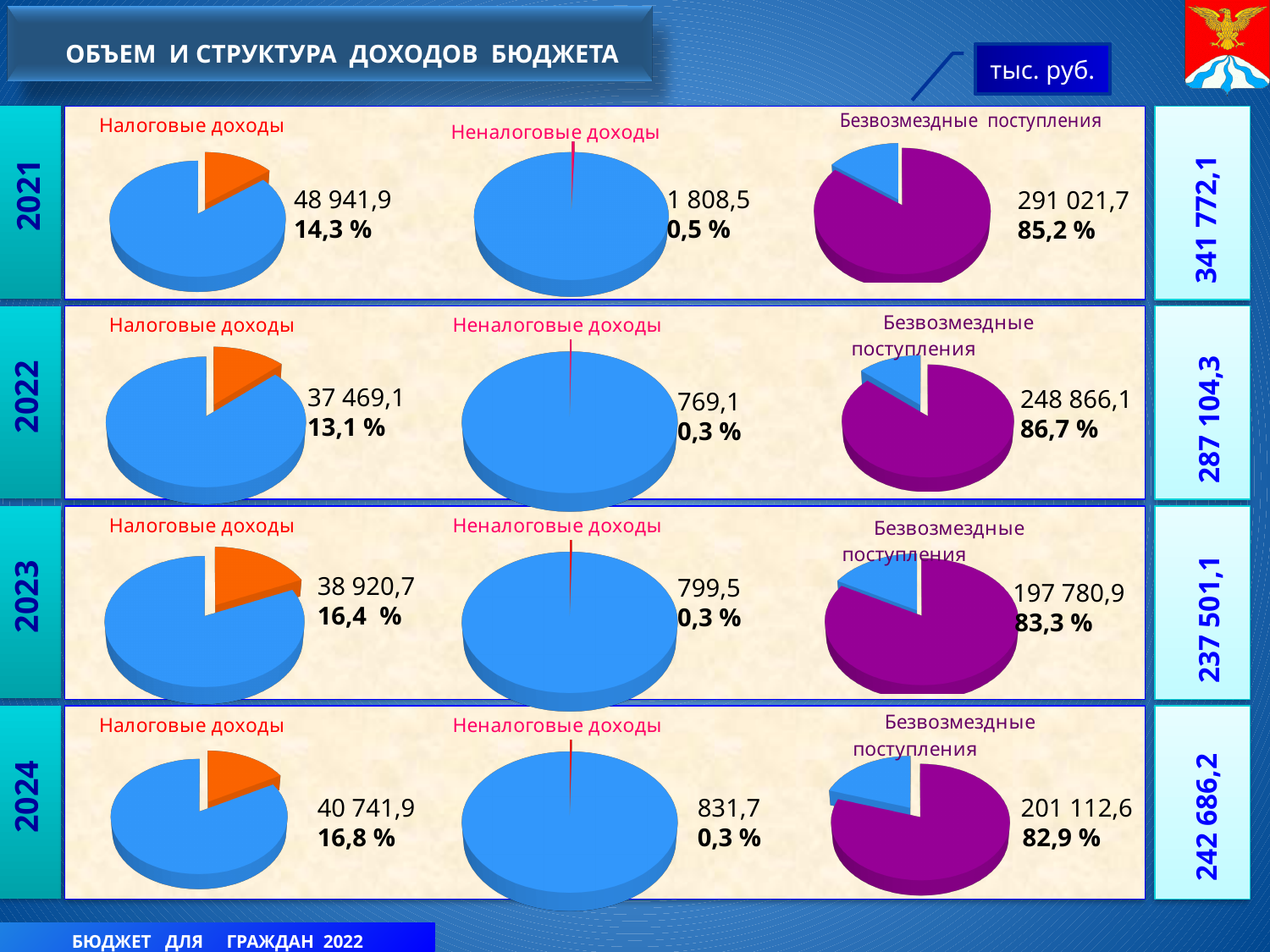
In the 2021 row, what value is shown on the 'Налоговые доходы' pie chart? 48 941,9 In the 2022 row, what value is shown on the 'Неналоговые доходы' pie chart? 769,1 How many pie charts are on the slide? 12 In the 2022 row, what percentage is shown on the 'Налоговые доходы' pie chart? 13,1 % In the 2021 row, what share does the 'Безвозмездные поступления' pie chart show for the highlighted slice? 85,2 % Which year's 'Неналоговые доходы' pie chart shows the lowest value? 2022 In the 2024 row, what percentage is shown on the 'Налоговые доходы' pie chart? 16,8 % What is the difference between the 'Налоговые доходы' values for 2024 and 2023? 1 821,2 What kind of charts are used on this slide? Pie charts In the 2023 row, what value is shown on the 'Безвозмездные поступления' pie chart? 197 780,9 Which is larger: the 'Безвозмездные поступления' value for 2022 or for 2024? 2022 Which year's 'Налоговые доходы' pie chart shows the highest value? 2021